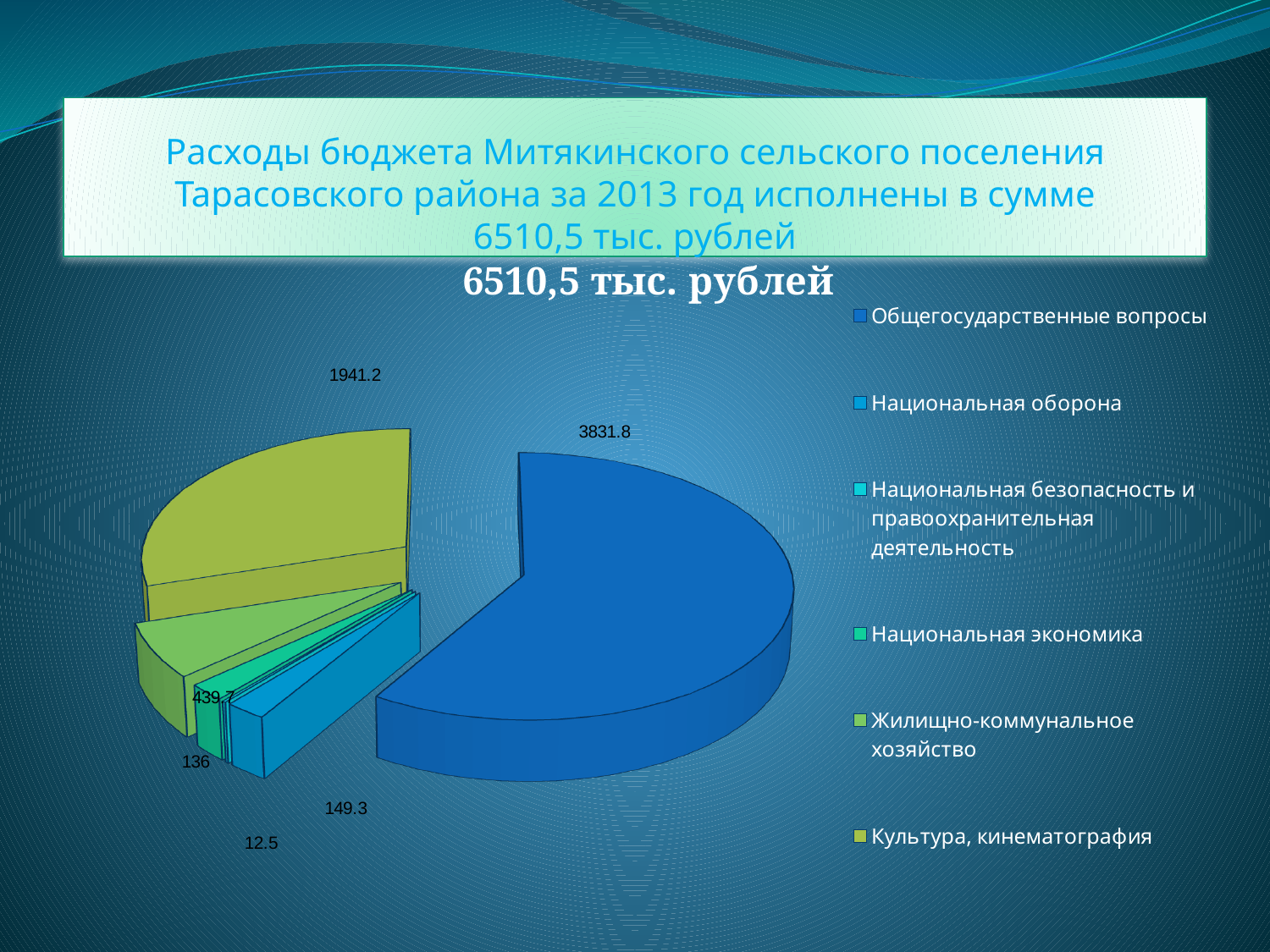
Which category has the largest slice of the pie? Общегосударственные вопросы Which is larger: Жилищно-коммунальное хозяйство or Национальная экономика? Жилищно-коммунальное хозяйство What is the value shown for Культура, кинематография? 1941.2 How many entries does the legend list? 6 What is the value shown for Общегосударственные вопросы? 3831.8 What is the title of the chart? 6510,5 тыс. рублей How many categories does the pie chart show? 6 What kind of chart is shown on the slide? Pie chart Which category has the smallest slice of the pie? Национальная безопасность и правоохранительная деятельность What is the difference between the values for Культура, кинематография and Жилищно-коммунальное хозяйство? 1501.5 What is the difference between the values for Общегосударственные вопросы and Культура, кинематография? 1890.6 What is the value shown for Жилищно-коммунальное хозяйство? 439.7